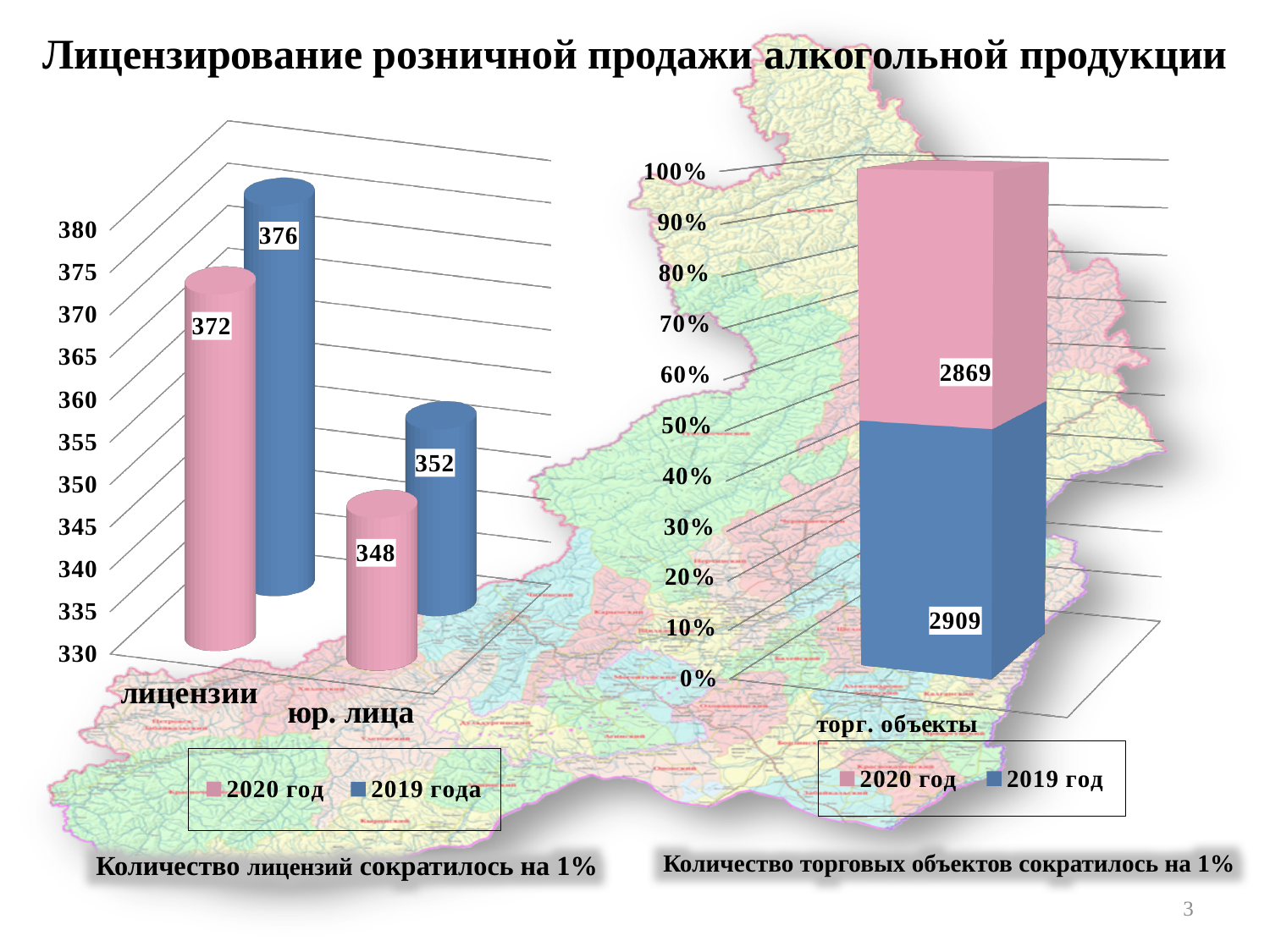
In the left chart, what is the value for юр. лица in 2020 год? 348 In the left chart, what is the value for лицензии in 2020 год? 372 In the left chart, what is the value for юр. лица in 2019 года? 352 In the right chart, which colour represents 2020 год in the legend? Pink In the right chart, what is the value for 2020 год for торг. объекты? 2869 In the right chart, what is the difference between the 2019 год and 2020 год values for торг. объекты? 40 In the left chart, how many categories are shown on the x axis? 2 In the left chart, what is the difference between the 2019 года and 2020 год values for лицензии? 4 In the left chart, how many series does the legend list? 2 In the left chart, which is larger for юр. лица: the 2020 год value or the 2019 года value? 2019 года In the left chart, which category has the highest value across both series? лицензии In the right chart, what is the value for 2019 год for торг. объекты? 2909